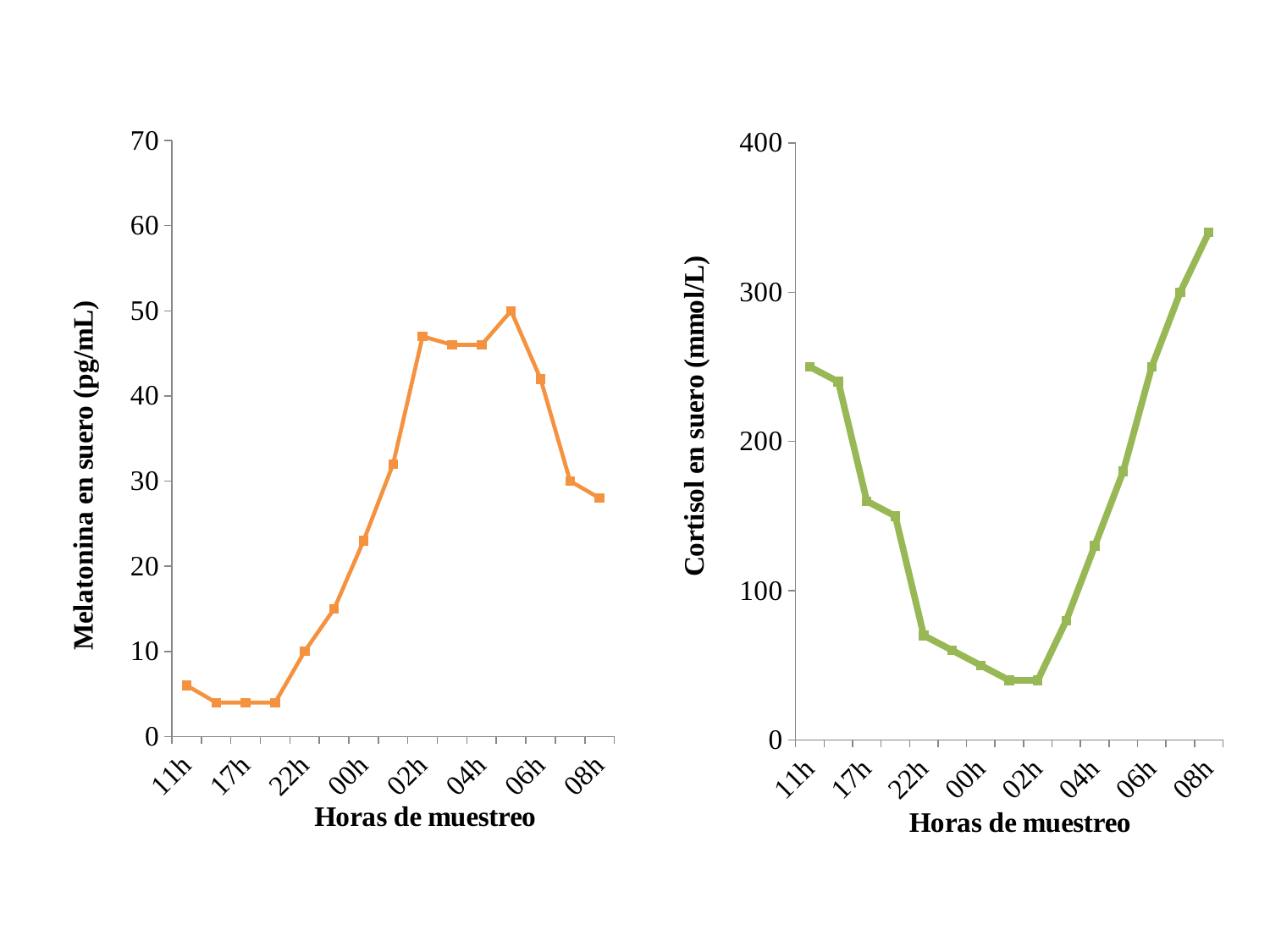
In the right chart (Cortisol en suero), which labelled sampling hour has the lowest cortisol value? 02h In the right chart (Cortisol en suero), which labelled sampling hour has the highest cortisol value? 08h What is the y-axis title of the right chart? Cortisol en suero (mmol/L) In the right chart (Cortisol en suero), is the value at 02h greater or less than 100? less In the right chart (Cortisol en suero), is the value at 08h greater or less than 300? greater What kind of chart is the left chart (Melatonina en suero)? line chart In the left chart (Melatonina en suero), which is larger, the value at 02h or the value at 08h? 02h In the left chart (Melatonina en suero), is the value at 00h greater or less than 20? greater What kind of chart is the right chart (Cortisol en suero)? line chart In the right chart (Cortisol en suero), do the values rise or fall from 02h to 08h? rise